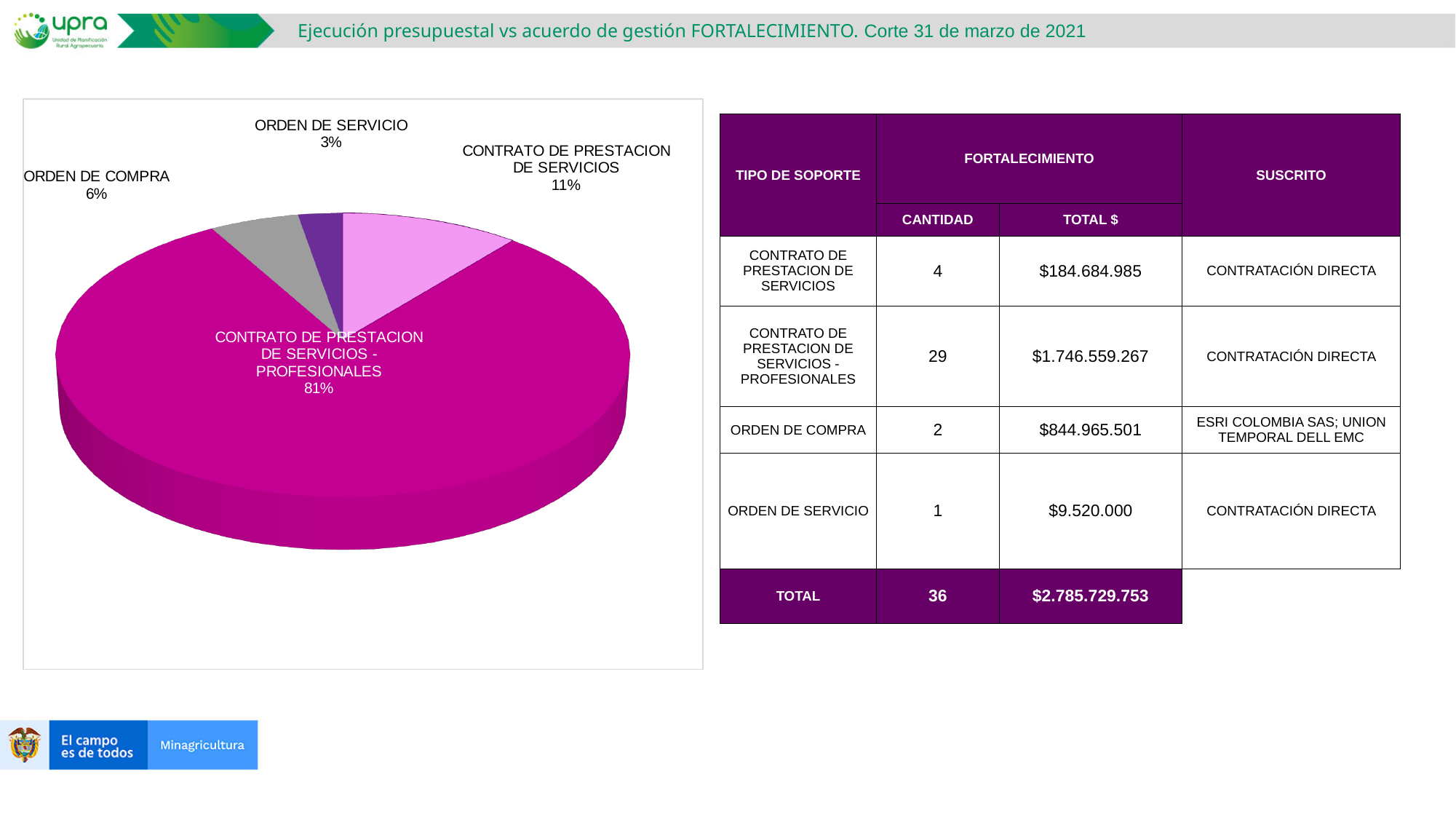
What percentage is shown for ORDEN DE SERVICIO in the pie chart? 3% What percentage is shown for ORDEN DE COMPRA in the pie chart? 6% What type of chart is shown on the slide? Pie chart What percentage is shown for CONTRATO DE PRESTACION DE SERVICIOS in the pie chart? 11% How many slices does the pie chart have? 4 In the pie chart, which is larger: ORDEN DE COMPRA or CONTRATO DE PRESTACION DE SERVICIOS? CONTRATO DE PRESTACION DE SERVICIOS What share of the pie chart does CONTRATO DE PRESTACION DE SERVICIOS - PROFESIONALES represent? 81% What is the difference in percentage points between CONTRATO DE PRESTACION DE SERVICIOS and ORDEN DE SERVICIO in the pie chart? 8 percentage points What colour is the largest slice of the pie chart? Magenta Which category has the largest slice in the pie chart? CONTRATO DE PRESTACION DE SERVICIOS - PROFESIONALES Which category has the smallest slice in the pie chart? ORDEN DE SERVICIO What is the difference in percentage points between ORDEN DE COMPRA and ORDEN DE SERVICIO in the pie chart? 3 percentage points